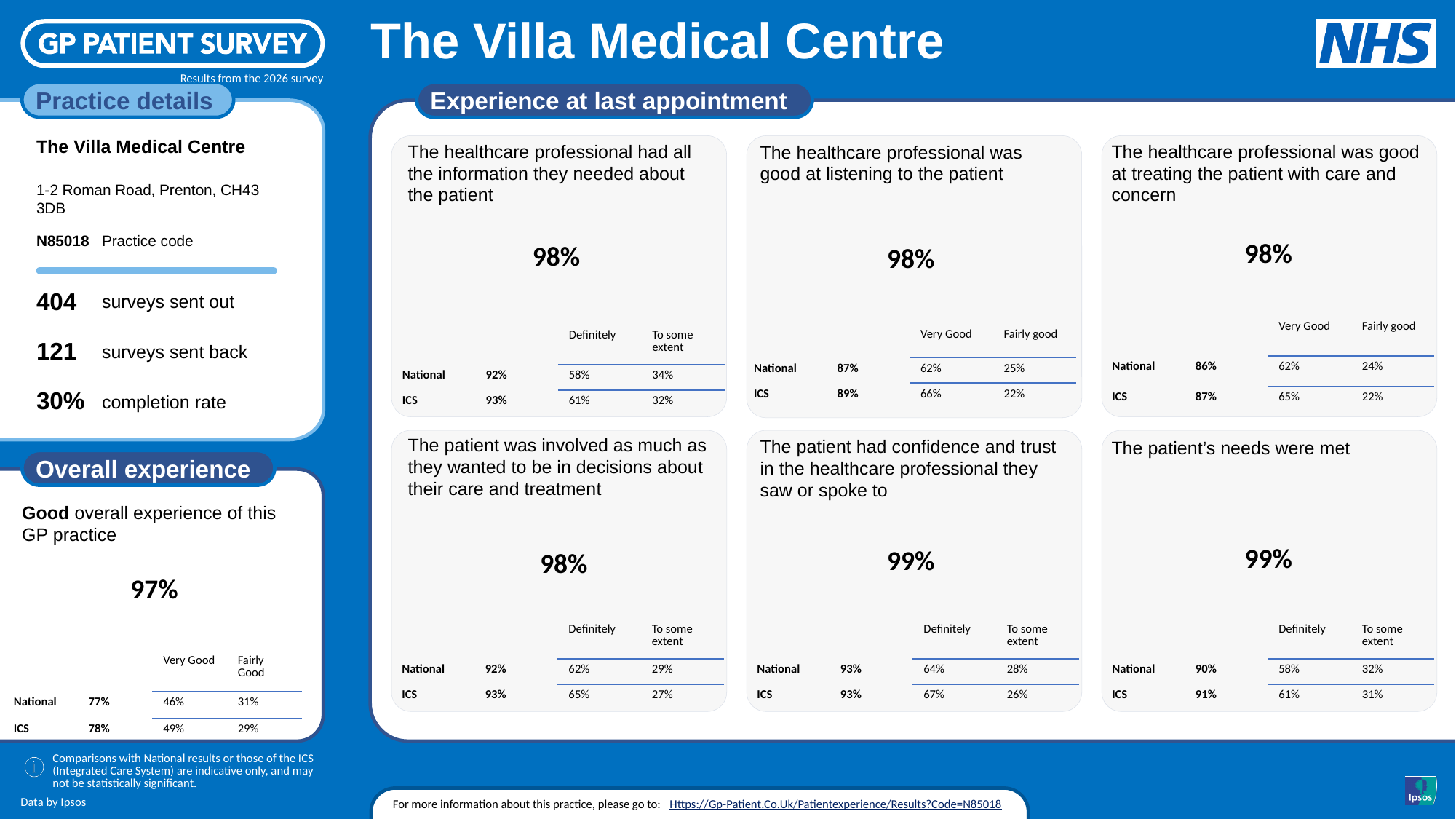
In the 'The healthcare professional was good at treating the patient with care and concern' panel, what is the ICS value? 87% In the 'Good overall experience of this GP practice' panel, what is the practice's value? 97% In the 'The patient had confidence and trust in the healthcare professional they saw or spoke to' panel, which is larger, the National value or the ICS value? They are equal (93%) In the 'The healthcare professional was good at listening to the patient' panel, what is the National 'Very Good' value? 62% In the 'The patient's needs were met' panel, which is larger, the National value or the ICS value? ICS In the 'Good overall experience of this GP practice' panel, what is the ICS 'Very Good' value? 49% In the 'The patient was involved as much as they wanted to be in decisions about their care and treatment' panel, what is the difference between the ICS 'Definitely' value and the National 'Definitely' value? 3% In the 'Good overall experience of this GP practice' panel, what is the difference between the practice's value and the National value? 20% How many question panels are shown under 'Experience at last appointment'? 6 In the 'The healthcare professional had all the information they needed about the patient' panel, what is the practice's value? 98% In the 'The patient's needs were met' panel, what is the practice's value? 99% In the 'Good overall experience of this GP practice' panel, what is the National value? 77%